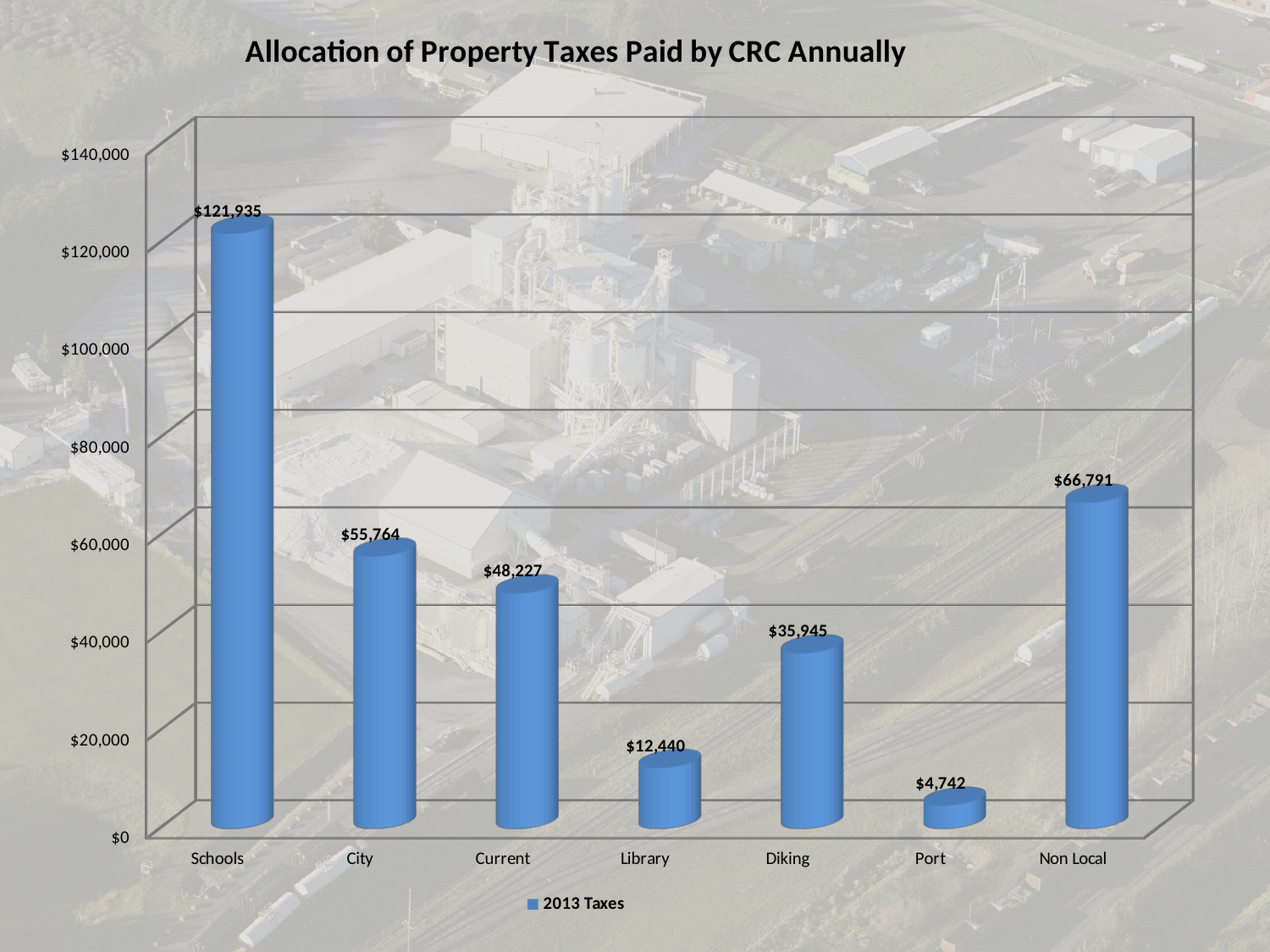
Which category has the lowest value? Port Is the value for Non Local greater or less than $60,000? greater What is the value for Non Local? $66,791 What is the title of the chart? Allocation of Property Taxes Paid by CRC Annually How many categories are shown on the x axis? 7 How many series does the legend list? 1 Which is larger, the value for Diking or the value for Library? Diking What kind of chart is shown? bar chart Which category has the highest value? Schools What is the value for Port? $4,742 What is the value for Schools? $121,935 What is the difference between the values for City and Current? $7,537